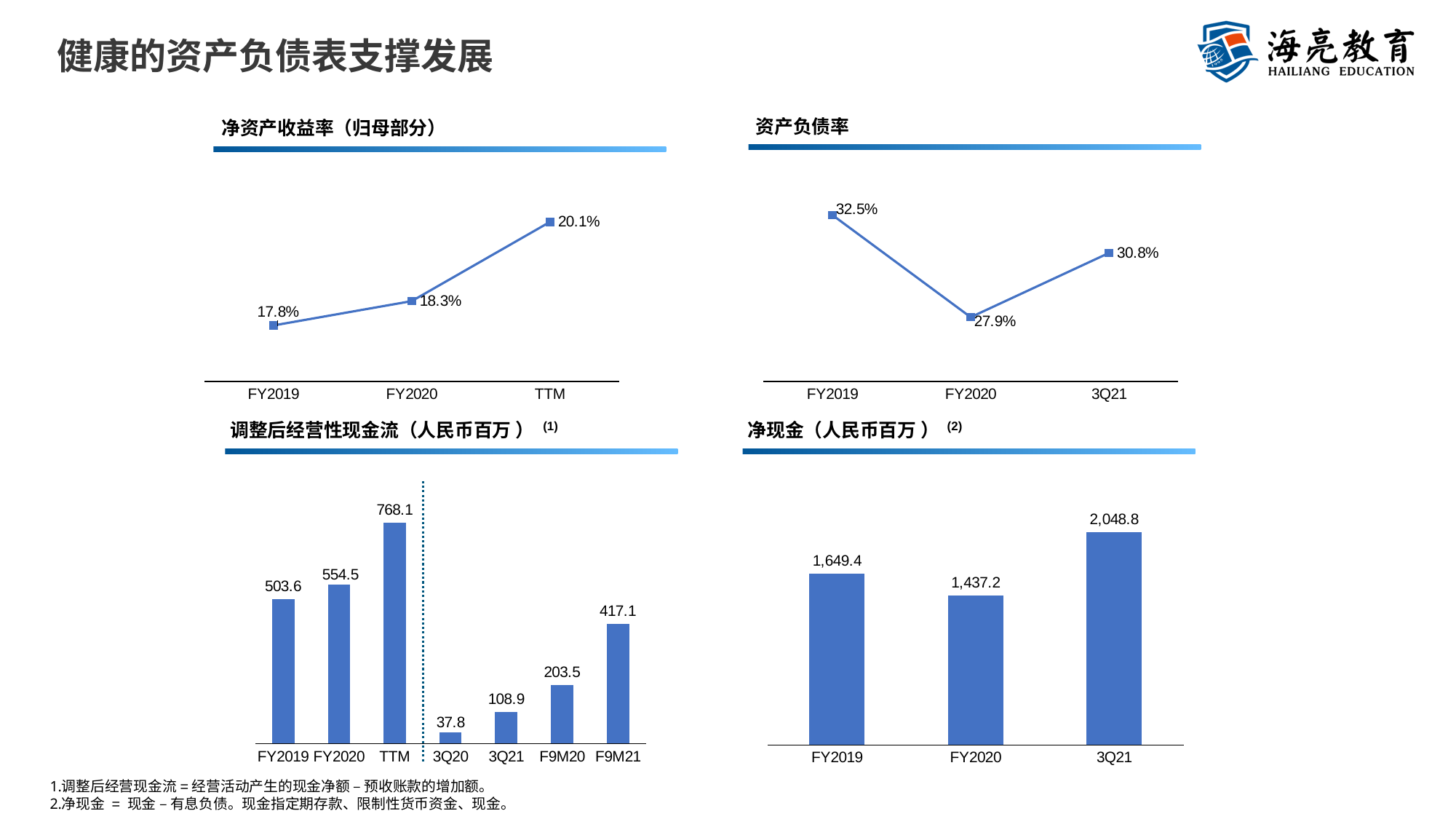
What kind of chart is the 净现金（人民币百万） chart (bottom right)? bar chart In the 净现金（人民币百万） chart (bottom right), what is the value for 3Q21? 2,048.8 In the 调整后经营性现金流（人民币百万） chart (bottom left), which period has the lowest value? 3Q20 In the 净资产收益率（归母部分） chart (top left), do the values rise or fall from FY2019 to TTM? rise In the 调整后经营性现金流（人民币百万） chart (bottom left), what is the value for F9M21? 417.1 In the 调整后经营性现金流（人民币百万） chart (bottom left), how many bars are plotted? 7 In the 净现金（人民币百万） chart (bottom right), which is larger, FY2019 or FY2020? FY2019 In the 资产负债率 chart (top right), which period has the highest value? FY2019 In the 净资产收益率（归母部分） chart (top left), what is the value for TTM? 20.1% In the 调整后经营性现金流（人民币百万） chart (bottom left), what is the difference between the TTM and FY2020 values? 213.6 In the 资产负债率 chart (top right), what is the difference between the FY2019 and FY2020 values? 4.6% In the 资产负债率 chart (top right), what is the value for FY2020? 27.9%